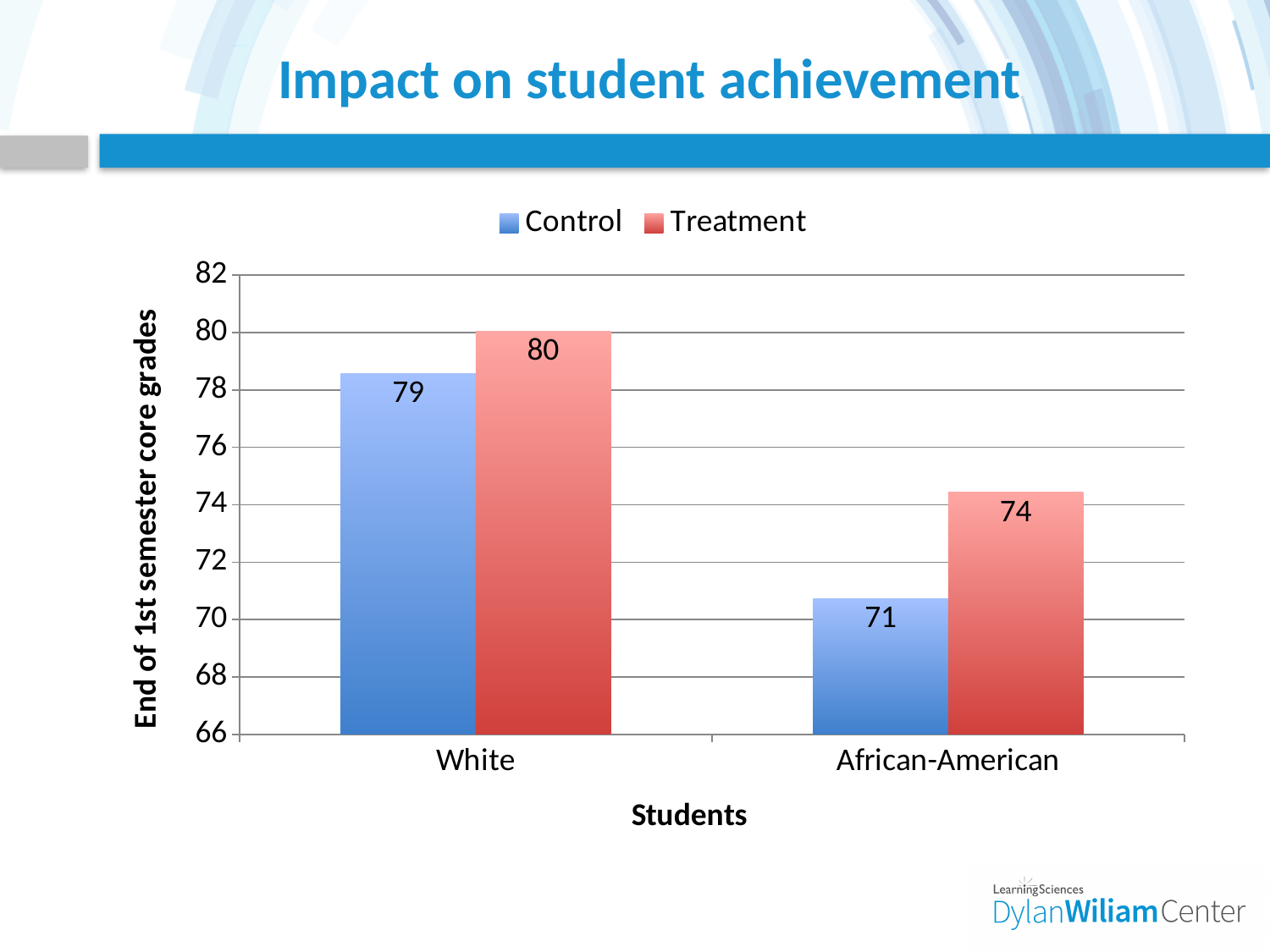
How many student groups are shown on the x axis? 2 What is the difference between the Treatment and Control values for African-American students? 3 What is the Control value for White students? 79 What is the Treatment value for White students? 80 How many series does the legend list? 2 Which is larger for White students, the Control value or the Treatment value? Treatment Which student group has the lowest Control value? African-American What is the Control value for African-American students? 71 What is the label of the vertical axis? End of 1st semester core grades What kind of chart is shown on the slide? Bar chart What is the Treatment value for African-American students? 74 Which student group has the highest Treatment value? White